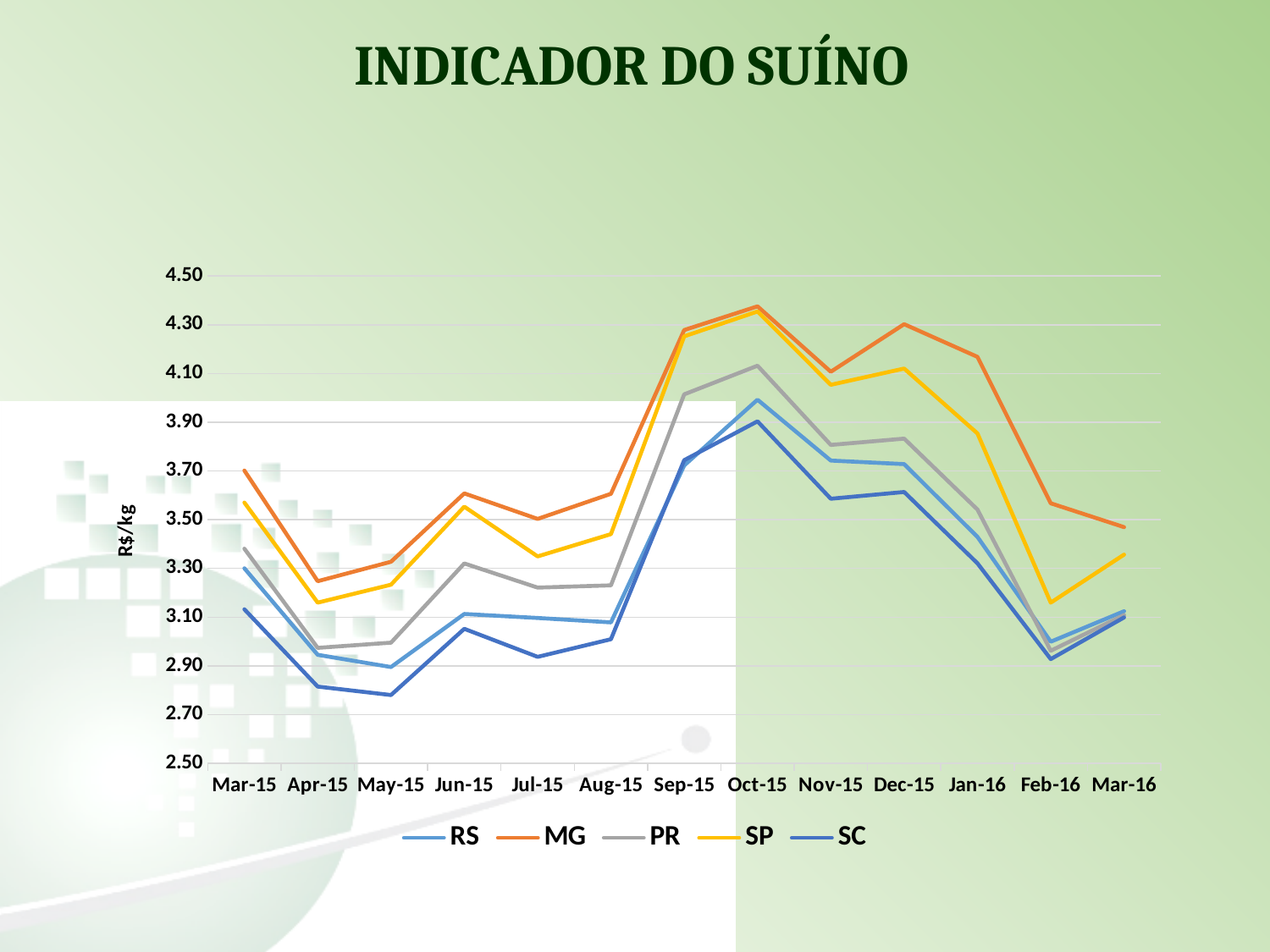
Is the value for SC in May-15 greater or less than 2.90? less Which series has the highest value in Dec-15? MG In which month does the SC series reach its highest value? Oct-15 Which is larger in Jan-16, the value for SP or the value for PR? SP Does the MG series rise or fall from Oct-15 to Feb-16? fall Which series has the lowest value in Mar-15? SC Is the value for MG in Jan-16 greater or less than 4.10? greater What is the label on the vertical axis? R$/kg What kind of chart is shown on the slide? line chart What is the title of the chart? INDICADOR DO SUÍNO How many series does the legend list? 5 How many months are plotted along the x axis? 13